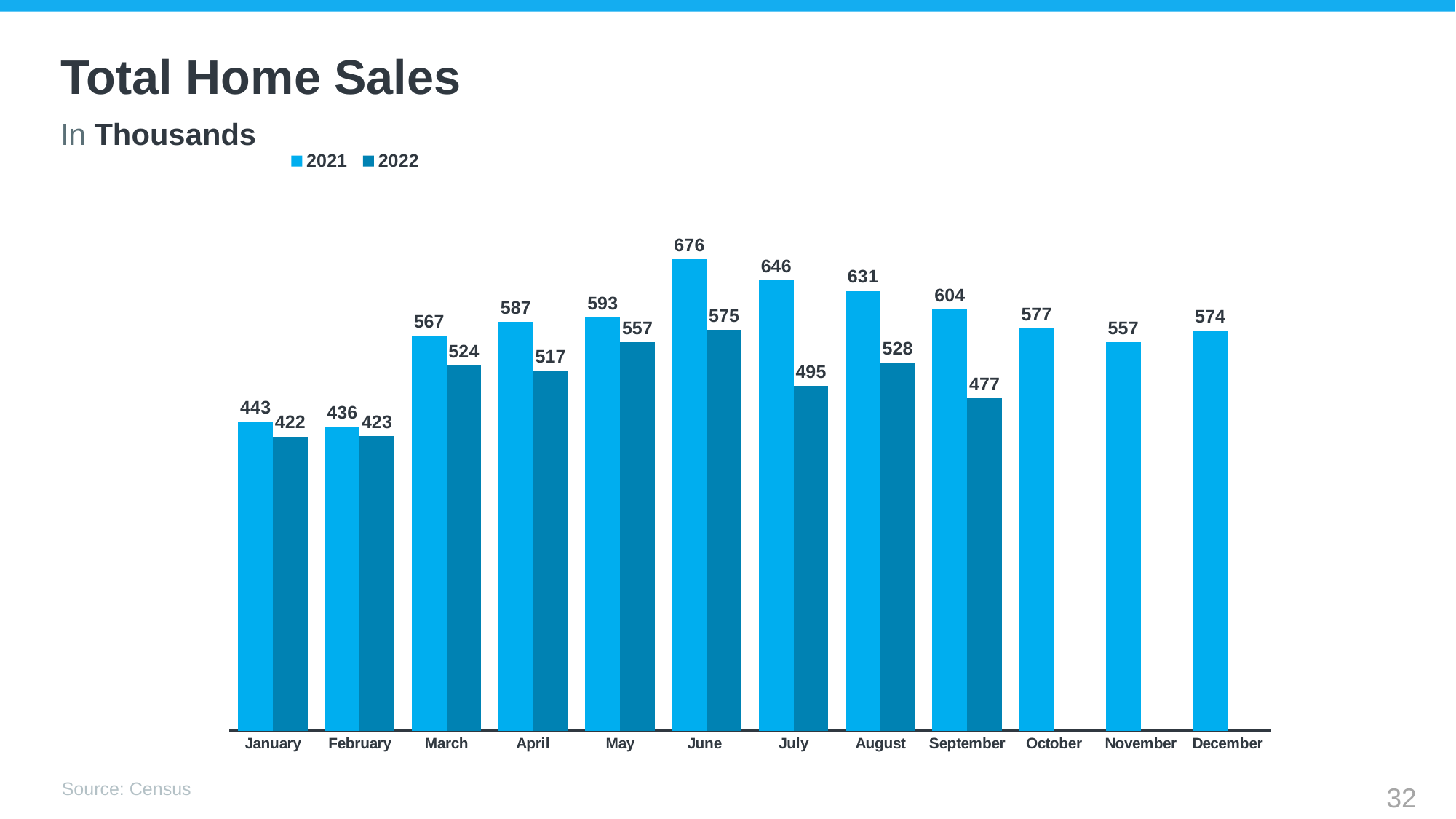
What was the value for June in 2021? 676 Which is larger, the 2022 value for May or the 2022 value for August? May What was the value for September in 2022? 477 What is the difference between the 2021 values for June and May? 83 What kind of chart is shown on the slide? Bar chart What was the value for December in 2021? 574 Which month has the lowest 2022 value? January Which month has the highest 2021 value? June How many months are shown on the x axis? 12 What is the title of the chart? Total Home Sales How many series does the legend list? 2 What is the difference between the 2021 and 2022 values for July? 151